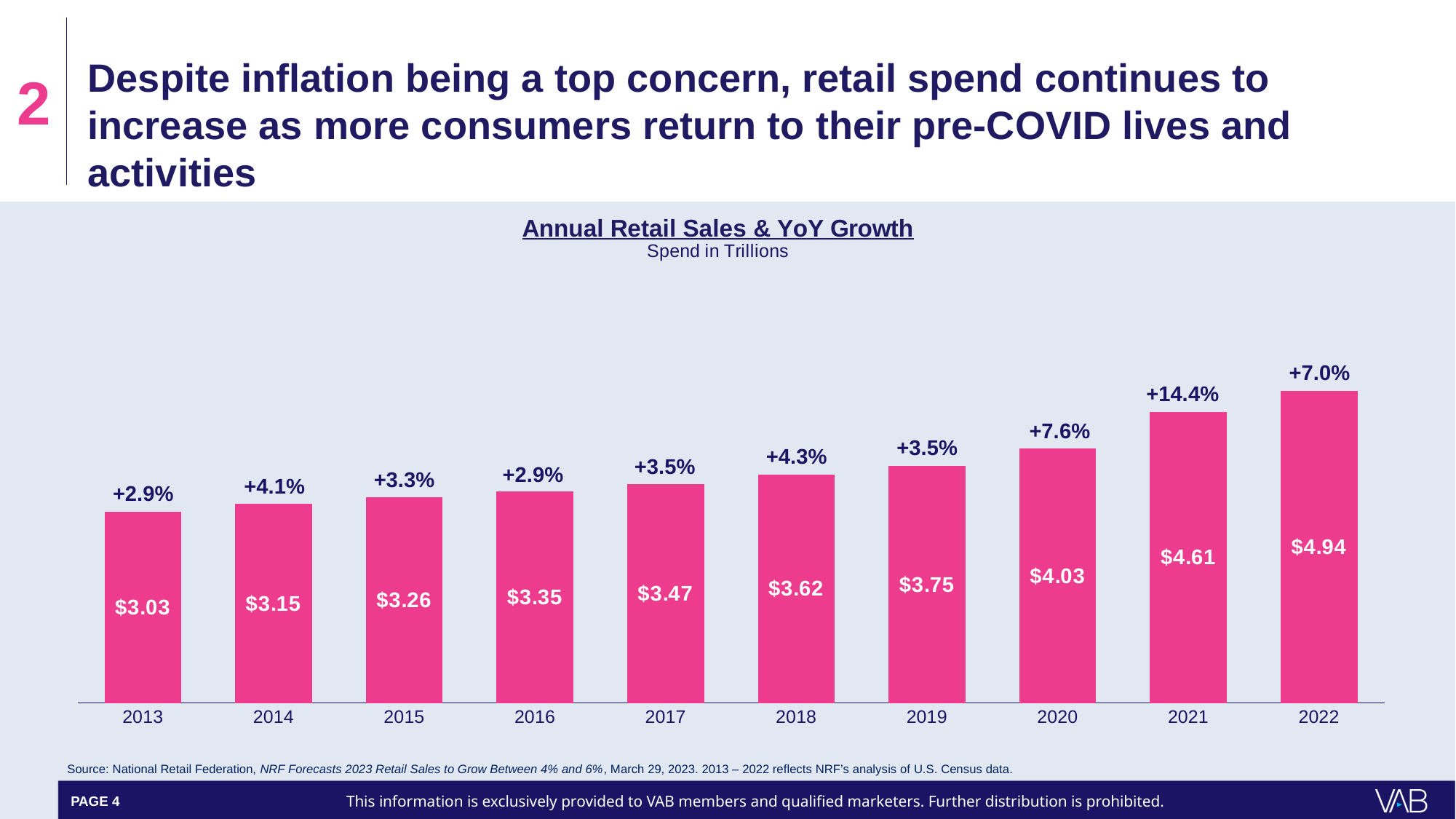
What type of chart is used to show Annual Retail Sales & YoY Growth? Bar chart What was the annual retail sales value for 2018? $3.62 Which year had higher retail sales, 2016 or 2019? 2019 What colour are the bars in the chart? Pink What YoY growth percentage is shown above the 2021 bar? +14.4% Which year has the highest annual retail sales? 2022 Do the annual retail sales values rise or fall from 2013 to 2022? Rise How many years are shown on the x axis of the chart? 10 Which year has the lowest annual retail sales? 2013 Which year shows the highest YoY growth percentage? 2021 What is the subtitle under the chart title indicating the unit of spend? Spend in Trillions What is the difference in retail sales between 2022 and 2021? $0.33